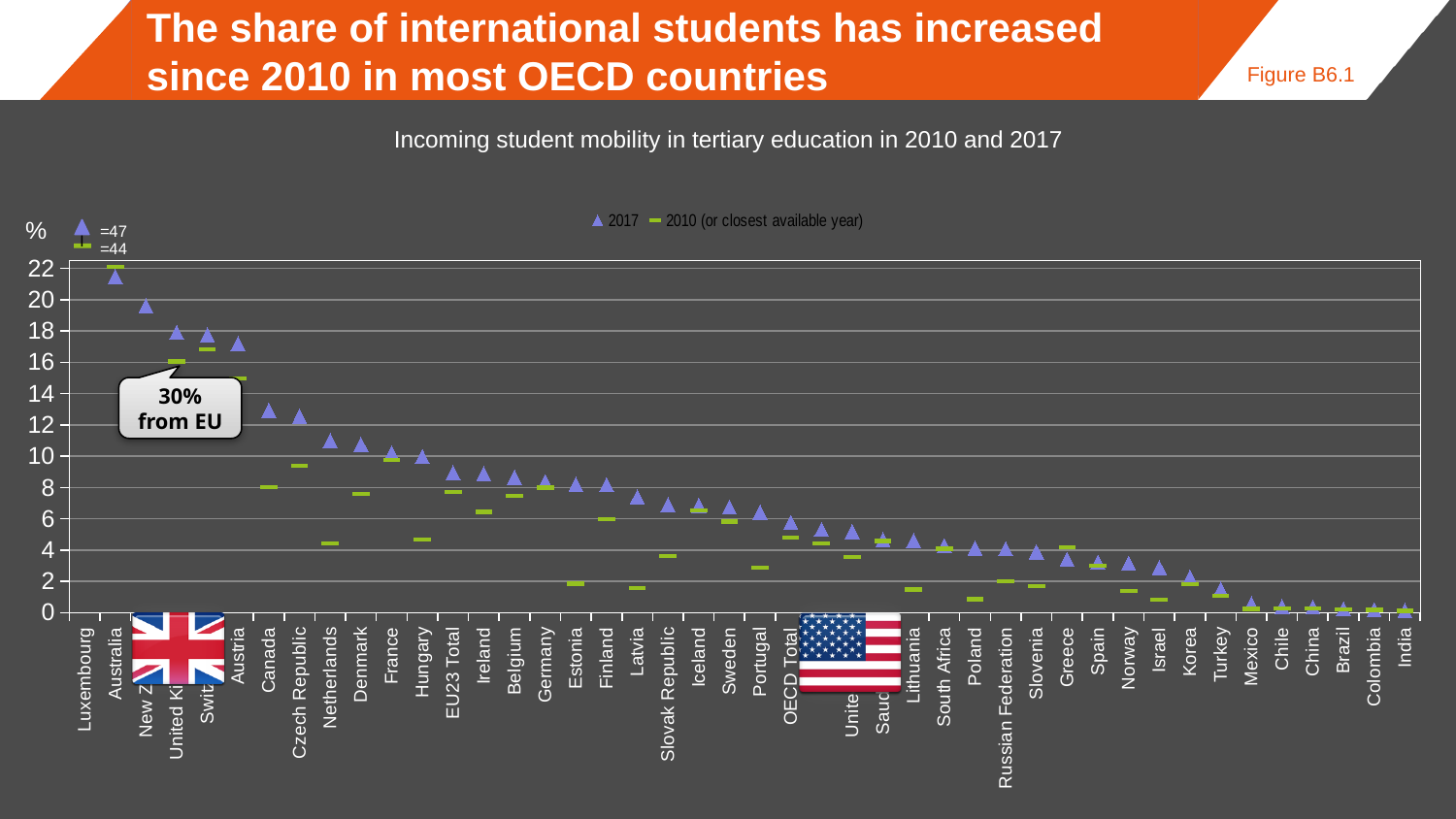
Is the 2017 value for Denmark greater or less than 10? greater How many series does the legend list? 2 Which is larger, the 2017 value for Australia or the 2017 value for Canada? Australia Is the 2017 value for Australia greater or less than 20? greater What does the callout box near the top left of the chart say? 30% from EU What is the 2010 value for Luxembourg? 44 What is the 2017 value for Luxembourg? 47 Which country has the highest 2017 value? Luxembourg Is the 2010 value for Poland greater or less than 2? less By how much did Luxembourg's value increase from 2010 to 2017? 3 Do the 2017 values rise or fall moving from left to right along the x axis? fall